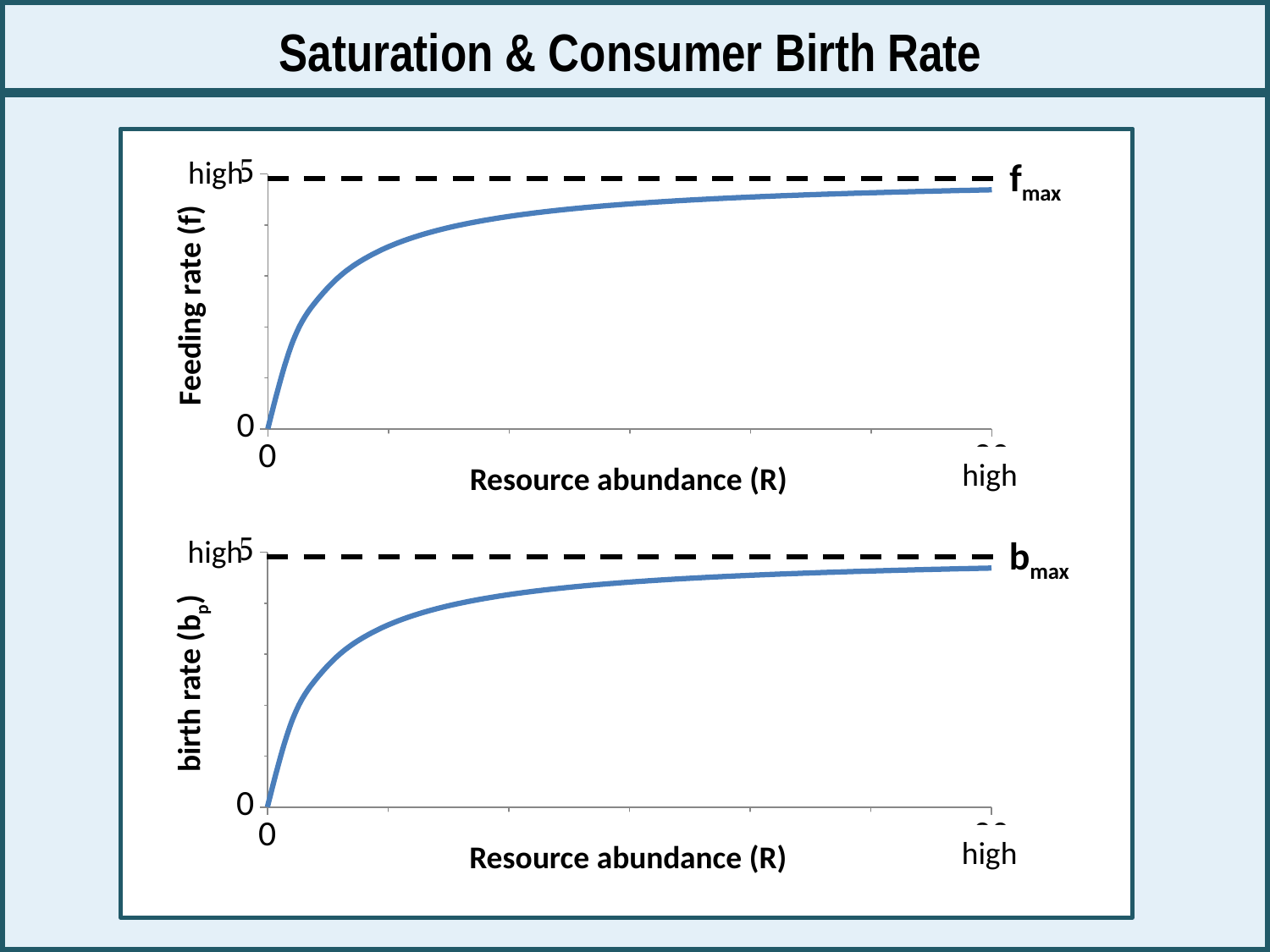
In the bottom chart, does the birth rate rise or fall as resource abundance increases? rise How many charts are shown on the slide? 2 What is the y-axis label of the top chart? Feeding rate (f) In the bottom chart, what is the value of the birth rate when resource abundance is 0? 0 In the top chart, does the feeding rate rise or fall as resource abundance increases? rise In the top chart, what label is given to the dashed horizontal line? fmax What kind of chart is the top chart on the slide? line chart What kind of chart is the bottom chart on the slide? line chart In the bottom chart, is the curve above or below the dashed bmax line at high resource abundance? below In the bottom chart, what label is given to the dashed horizontal line? bmax What is the x-axis label of the top chart? Resource abundance (R) In the top chart, what is the value of the feeding rate when resource abundance is 0? 0